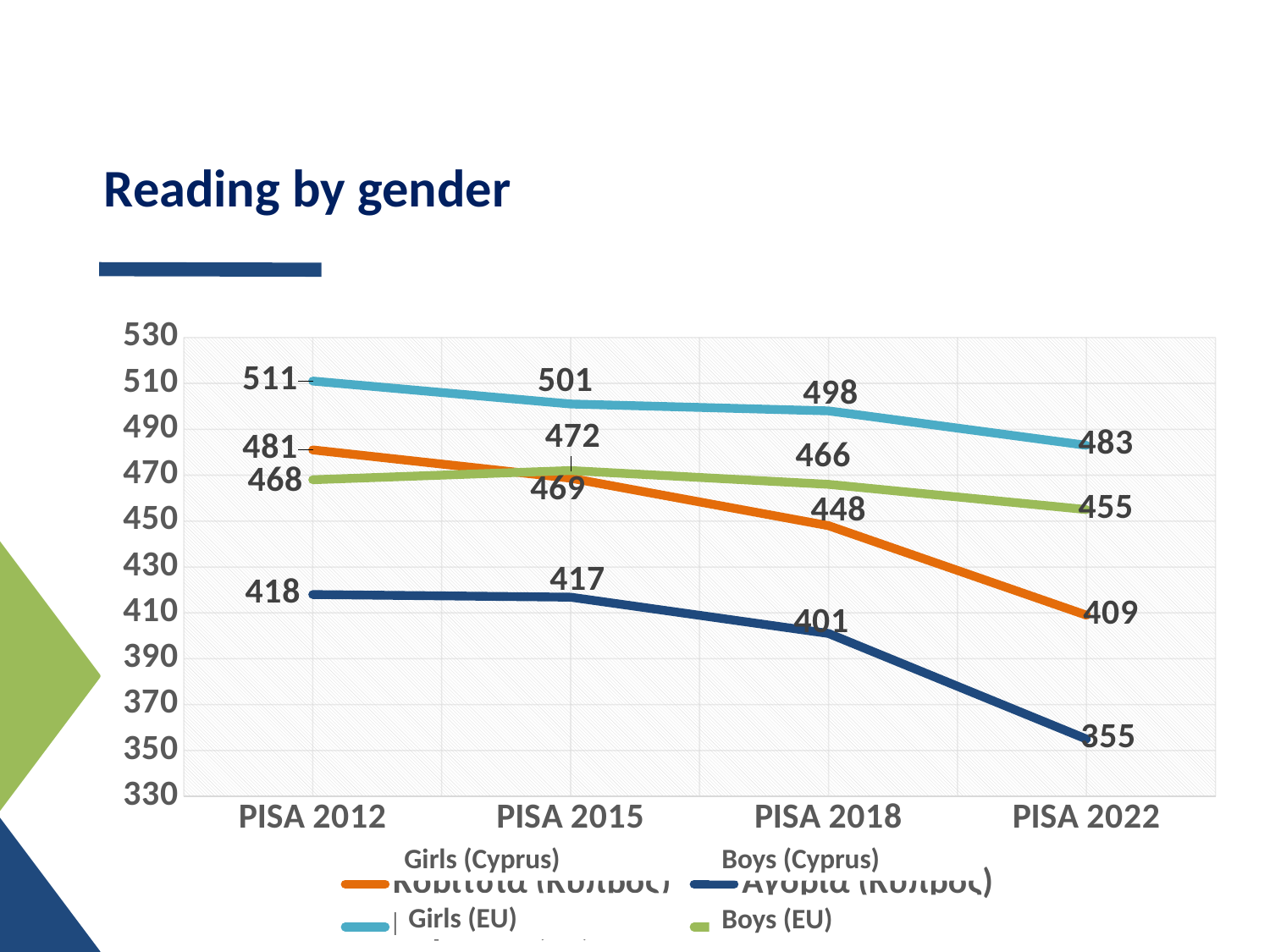
Which series has the lowest value in PISA 2022? Boys (Cyprus) What is the value for Girls (Cyprus) in PISA 2018? 448 How many PISA cycles are shown on the x axis? 4 What is the value for Boys (Cyprus) in PISA 2022? 355 Which is larger in PISA 2015: Girls (Cyprus) or Boys (EU)? Boys (EU) What is the value for Boys (EU) in PISA 2015? 472 What is the difference between Girls (Cyprus) and Boys (Cyprus) in PISA 2022? 54 How many series does the legend list? 4 What is the value for Girls (EU) in PISA 2012? 511 Does the Girls (Cyprus) series rise or fall from PISA 2012 to PISA 2022? fall What type of chart is shown on the slide? line chart What is the title of the chart? Reading by gender